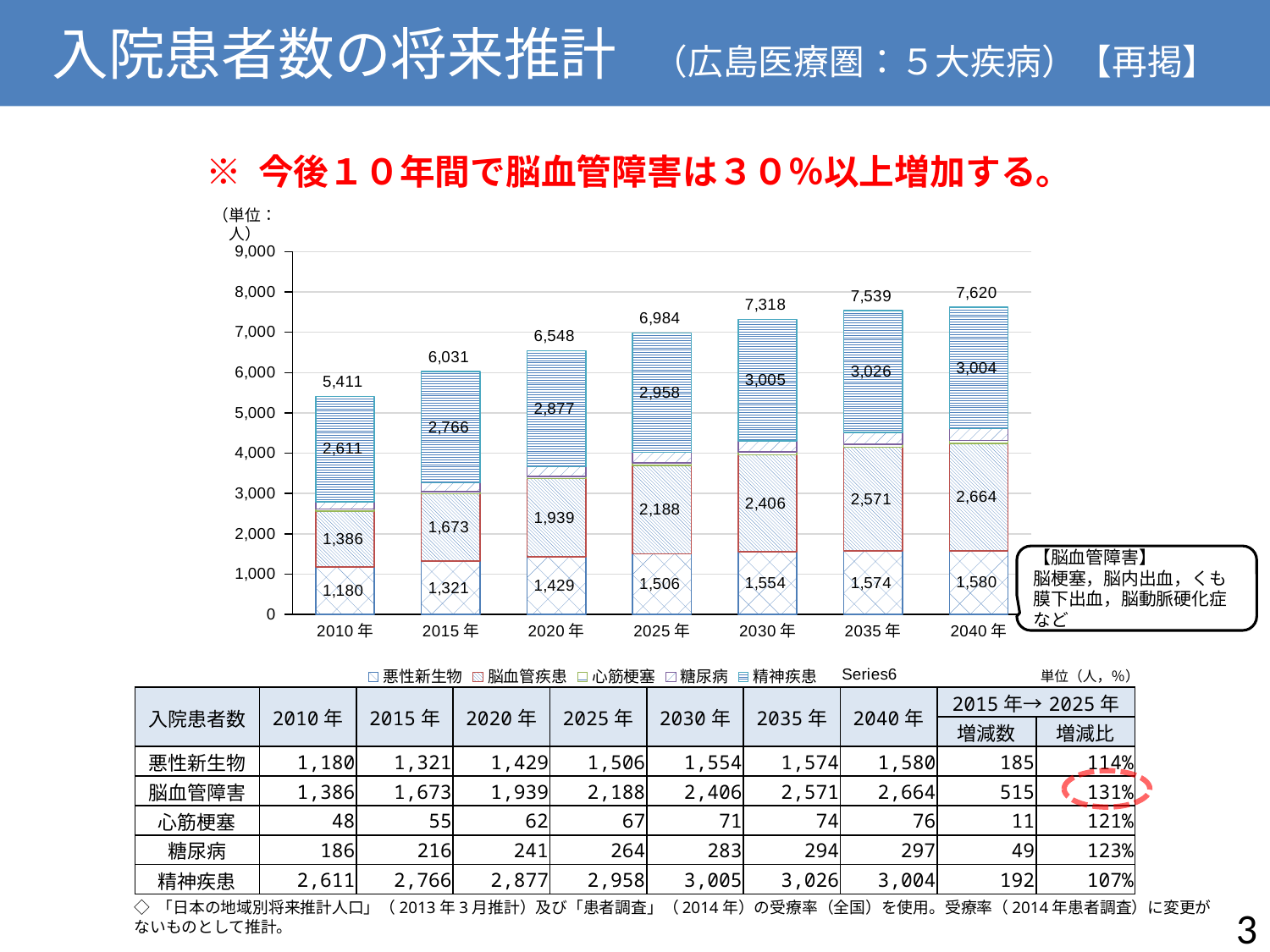
What is the value of 精神疾患 in the 2035年 bar? 3,026 What is the difference between the 脳血管疾患 values for 2025年 and 2015年? 515 What type of chart is shown on the slide? stacked bar chart What is the total number of inpatients shown above the bar for 2010年? 5,411 Which year has the lowest total bar in the chart? 2010年 What is the total number of inpatients shown above the bar for 2040年? 7,620 What is the value of 脳血管疾患 in the 2025年 bar? 2,188 How many years (categories) are plotted on the x axis of the chart? 7 Which year has the highest total bar in the chart? 2040年 How many series does the chart legend list? 6 Do the total bar values rise or fall from 2010年 to 2040年? rise What is the value of 悪性新生物 in the 2015年 bar? 1,321